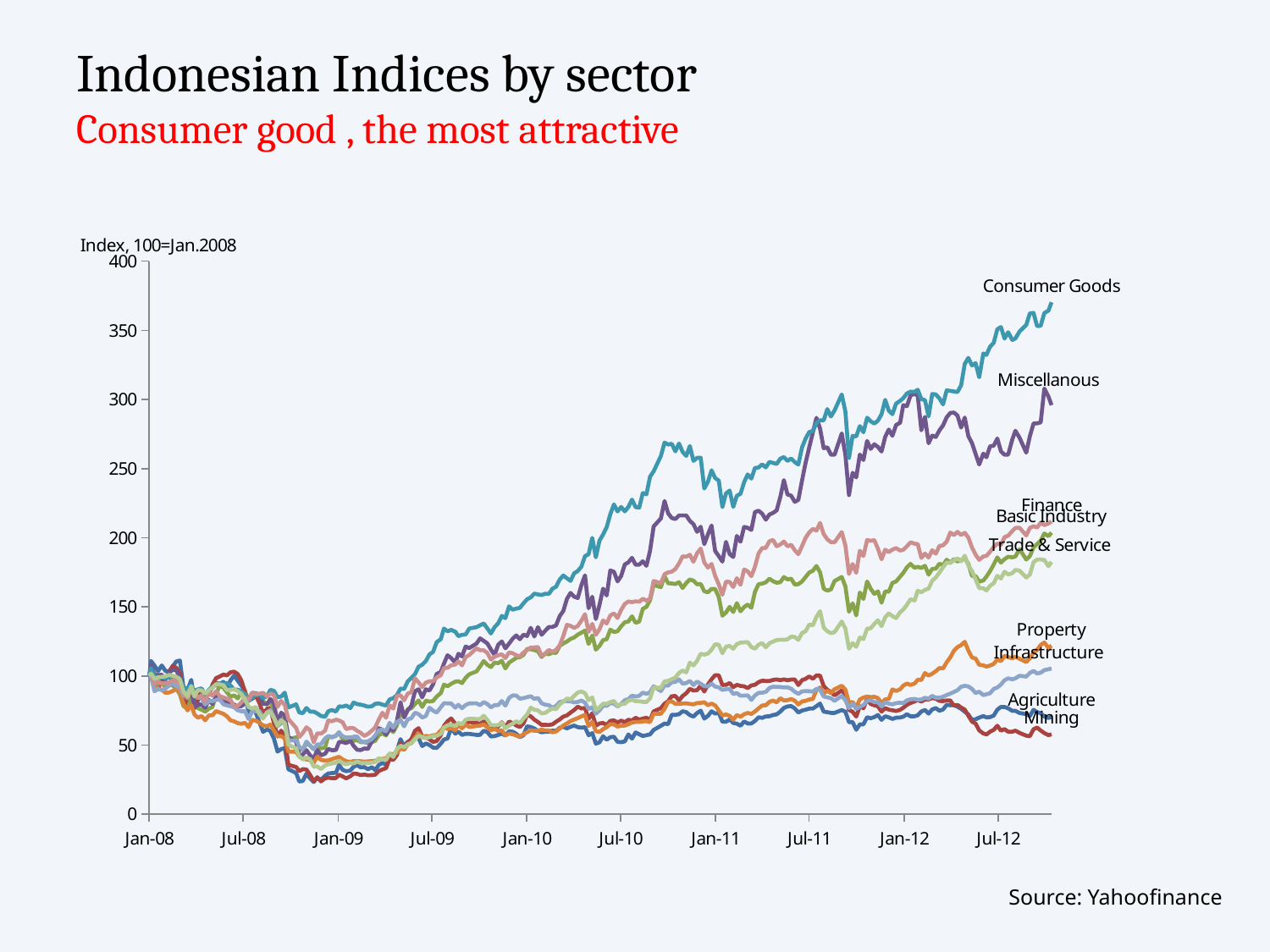
Which sector index is the lowest at the end of the chart (after Jul-12)? Mining At the end of the chart, which is higher: the Finance index or the Property index? Finance What is the source cited for the chart? Yahoofinance How many date labels are shown on the x axis? 10 Is the Mining index at the end of the chart greater or less than 100? less Is the Trade & Service index at the end of the chart greater or less than 200? less Is the Consumer Goods index at the end of the chart greater or less than 350? greater How many sector series are labelled on the chart? 9 Does the Consumer Goods index rise or fall between Jan-09 and Jul-12? Rises Which sector index is the highest at the end of the chart (after Jul-12)? Consumer Goods What kind of chart is shown on the slide? Line chart